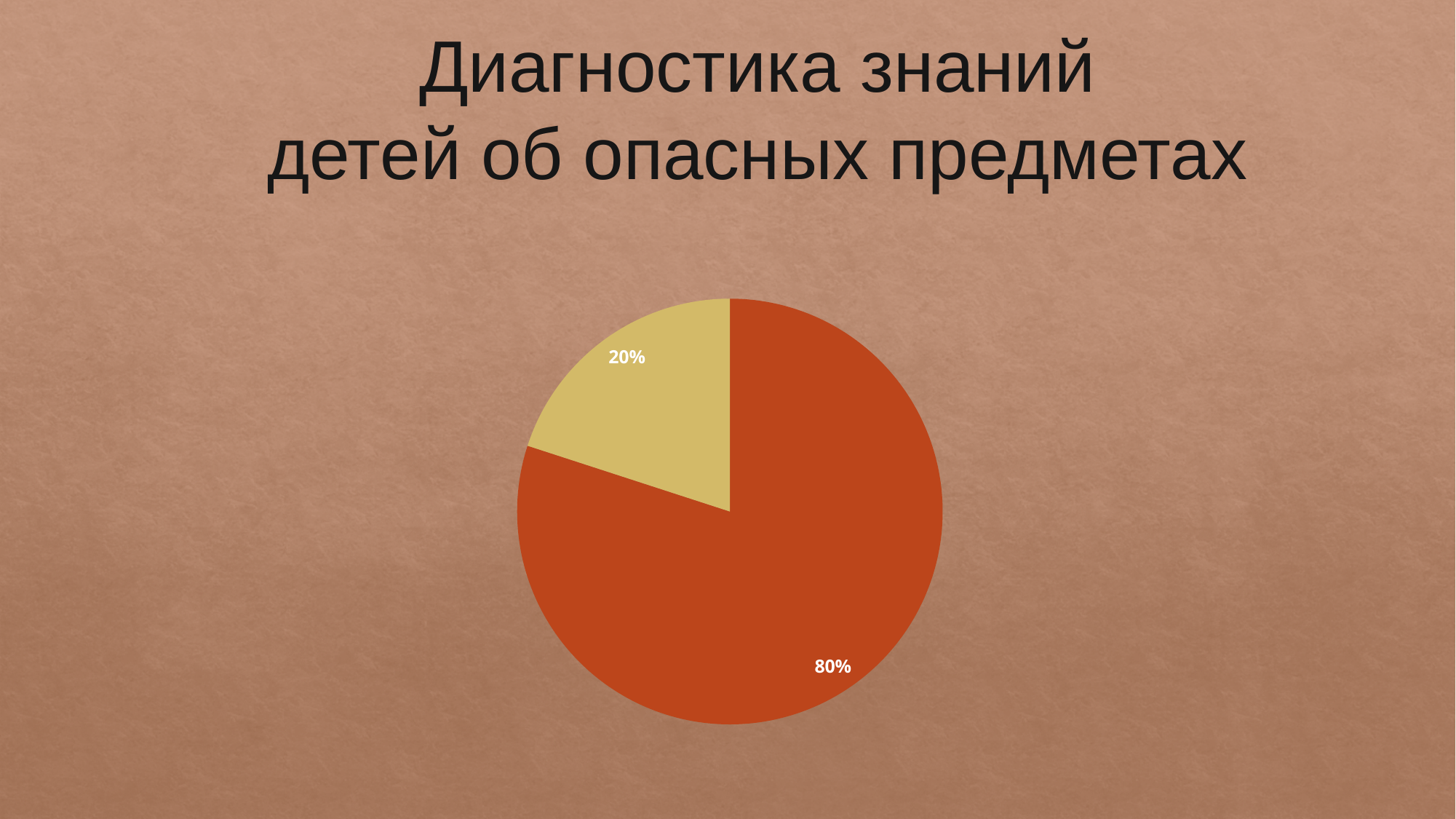
What share of the pie does the yellow slice represent? 20% What percentage is shown on the orange slice of the pie chart? 80% Is the value of the orange slice greater or less than 50%? greater How many slices does the pie chart have? 2 Does the pie chart have a legend? No What is the difference in percentage points between the orange slice and the yellow slice? 60 What kind of chart is shown on the slide? pie chart Which slice of the pie chart is the smallest? the yellow slice (20%) What is the title shown above the pie chart on the slide? Диагностика знаний детей об опасных предметах What percentage is shown on the yellow slice of the pie chart? 20% Which slice is larger, the orange one or the yellow one? the orange one Which slice of the pie chart is the largest? the orange slice (80%)